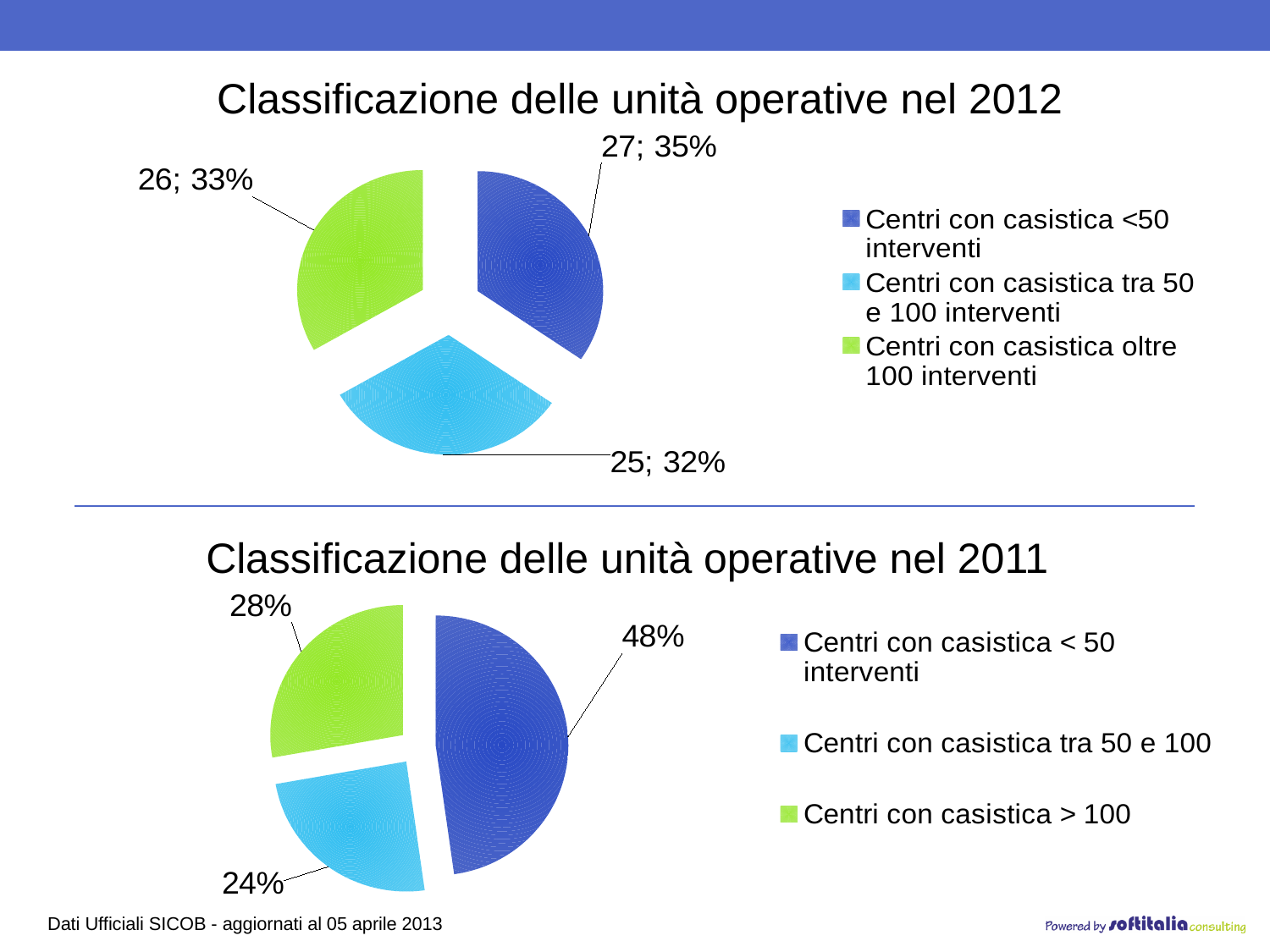
In the chart 'Classificazione delle unità operative nel 2011', what share does 'Centri con casistica tra 50 e 100' have? 24% In the chart 'Classificazione delle unità operative nel 2012', which category has the largest slice? Centri con casistica <50 interventi In the chart 'Classificazione delle unità operative nel 2011', what is the difference in percentage points between 'Centri con casistica < 50 interventi' and 'Centri con casistica > 100'? 20 In the chart 'Classificazione delle unità operative nel 2012', what is the difference in count between 'Centri con casistica <50 interventi' and 'Centri con casistica tra 50 e 100 interventi'? 2 How many categories does the legend of the chart 'Classificazione delle unità operative nel 2012' list? 3 In the chart 'Classificazione delle unità operative nel 2012', what is the value for 'Centri con casistica tra 50 e 100 interventi'? 25; 32% In the chart 'Classificazione delle unità operative nel 2012', what is the value for 'Centri con casistica <50 interventi'? 27; 35% What kind of chart is 'Classificazione delle unità operative nel 2011'? Pie chart In the chart 'Classificazione delle unità operative nel 2012', what is the total count across all three categories? 78 In the chart 'Classificazione delle unità operative nel 2012', what is the value for 'Centri con casistica oltre 100 interventi'? 26; 33% In the chart 'Classificazione delle unità operative nel 2011', which category has the smallest slice? Centri con casistica tra 50 e 100 In the chart 'Classificazione delle unità operative nel 2011', what share does 'Centri con casistica < 50 interventi' have? 48%